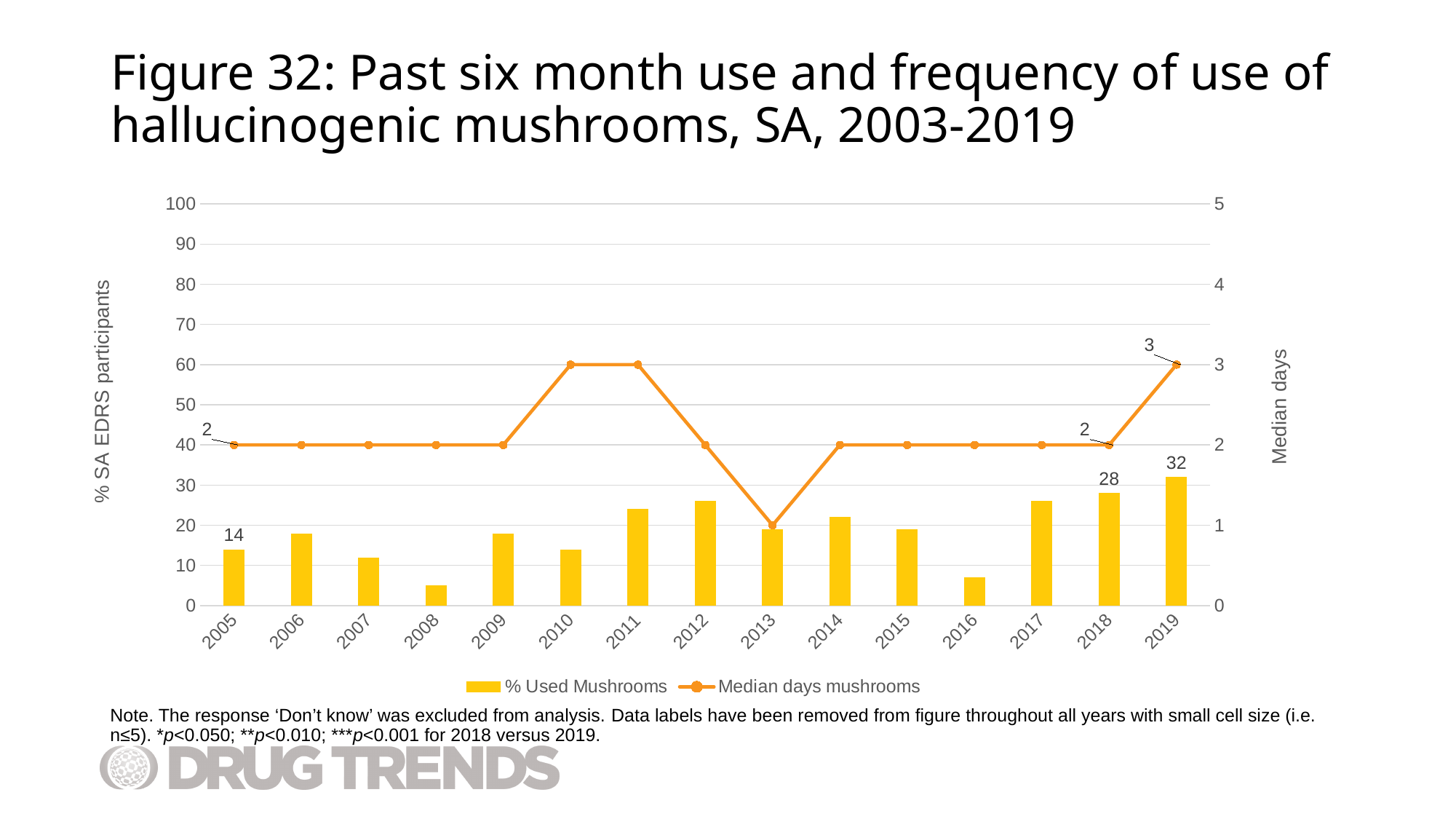
How many series does the legend list? 2 Is the % Used Mushrooms value for 2008 greater or less than 10? less Which year has the highest % Used Mushrooms value? 2019 Does the median days mushrooms line rise or fall from 2018 to 2019? rise What is the difference between the % Used Mushrooms values for 2019 and 2018? 4 What is the median days mushrooms value for 2013? 1 What is the value of % Used Mushrooms for 2005? 14 What is the median days mushrooms value for 2019? 3 How many years are shown on the x axis? 15 Which year has the lowest % Used Mushrooms value? 2008 What is the value of % Used Mushrooms for 2018? 28 What is the value of % Used Mushrooms for 2019? 32